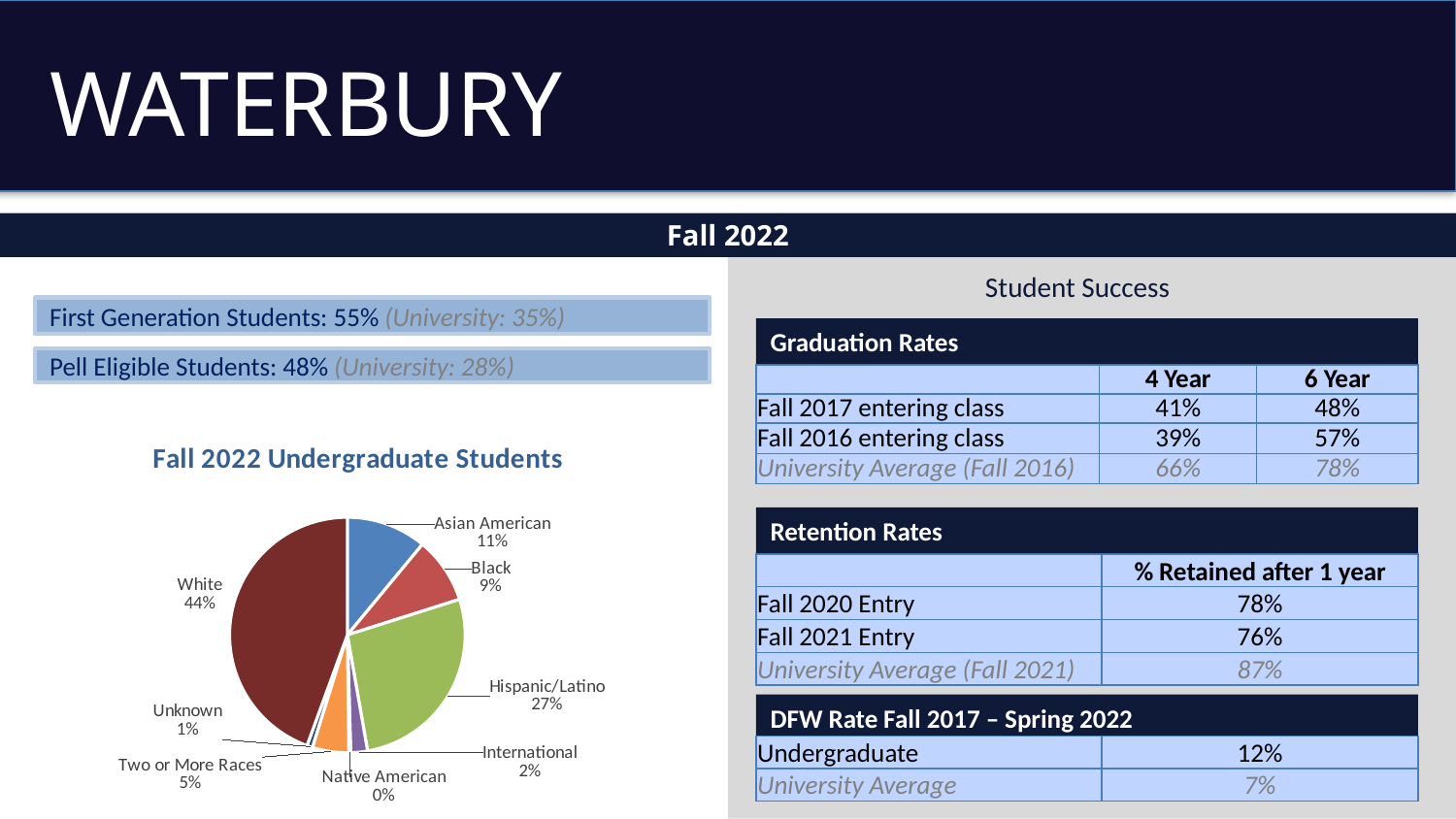
How many categories are shown in the pie chart? 8 What is the share for International students? 2% What is the title of the chart? Fall 2022 Undergraduate Students Which category has the largest slice of the pie? White Which category has the smallest slice of the pie? Native American What type of chart is shown on the slide? pie chart What percentage of the pie is labelled Two or More Races? 5% What is the difference between the White and Hispanic/Latino shares? 17% What share of Fall 2022 undergraduate students is Hispanic/Latino? 27% What percentage of the pie is labelled Asian American? 11% What share of Fall 2022 undergraduate students is White? 44% Which is larger, the Black share or the Asian American share? Asian American